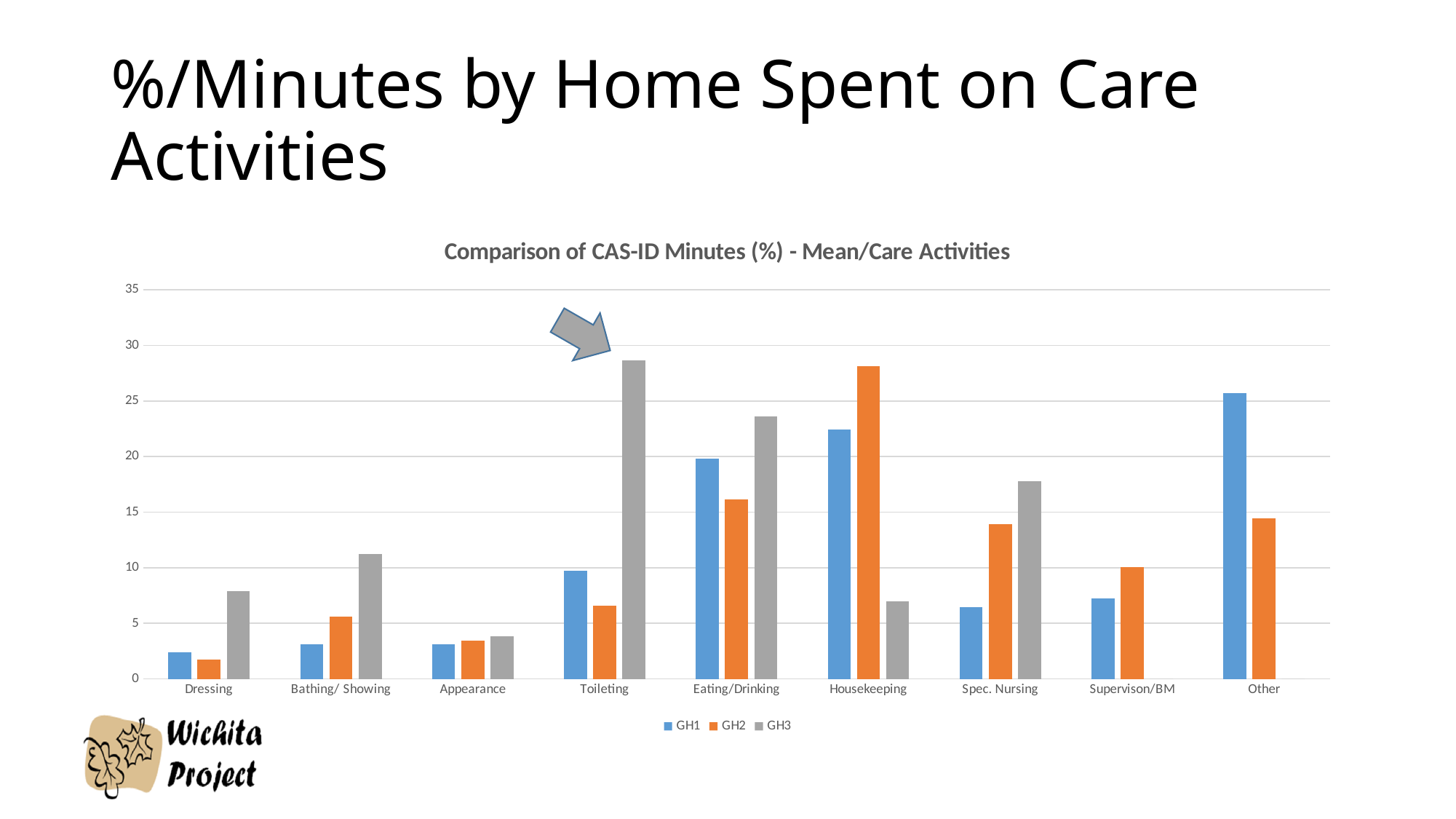
Is the GH3 value for Toileting greater or less than 25? greater What kind of chart is shown on the slide? Bar chart Which care activity has the highest GH2 value? Housekeeping Which care activity has the highest GH3 value? Toileting Is the GH2 value for Housekeeping greater or less than 25? greater What is the title of the chart? Comparison of CAS-ID Minutes (%) - Mean/Care Activities For Housekeeping, which is larger: the GH2 value or the GH3 value? GH2 Which care activity has the highest GH1 value? Other How many series does the legend list? 3 Is the GH1 value for Dressing greater or less than 5? less How many care activity categories are shown on the x axis? 9 For Eating/Drinking, which is larger: the GH1 value or the GH2 value? GH1